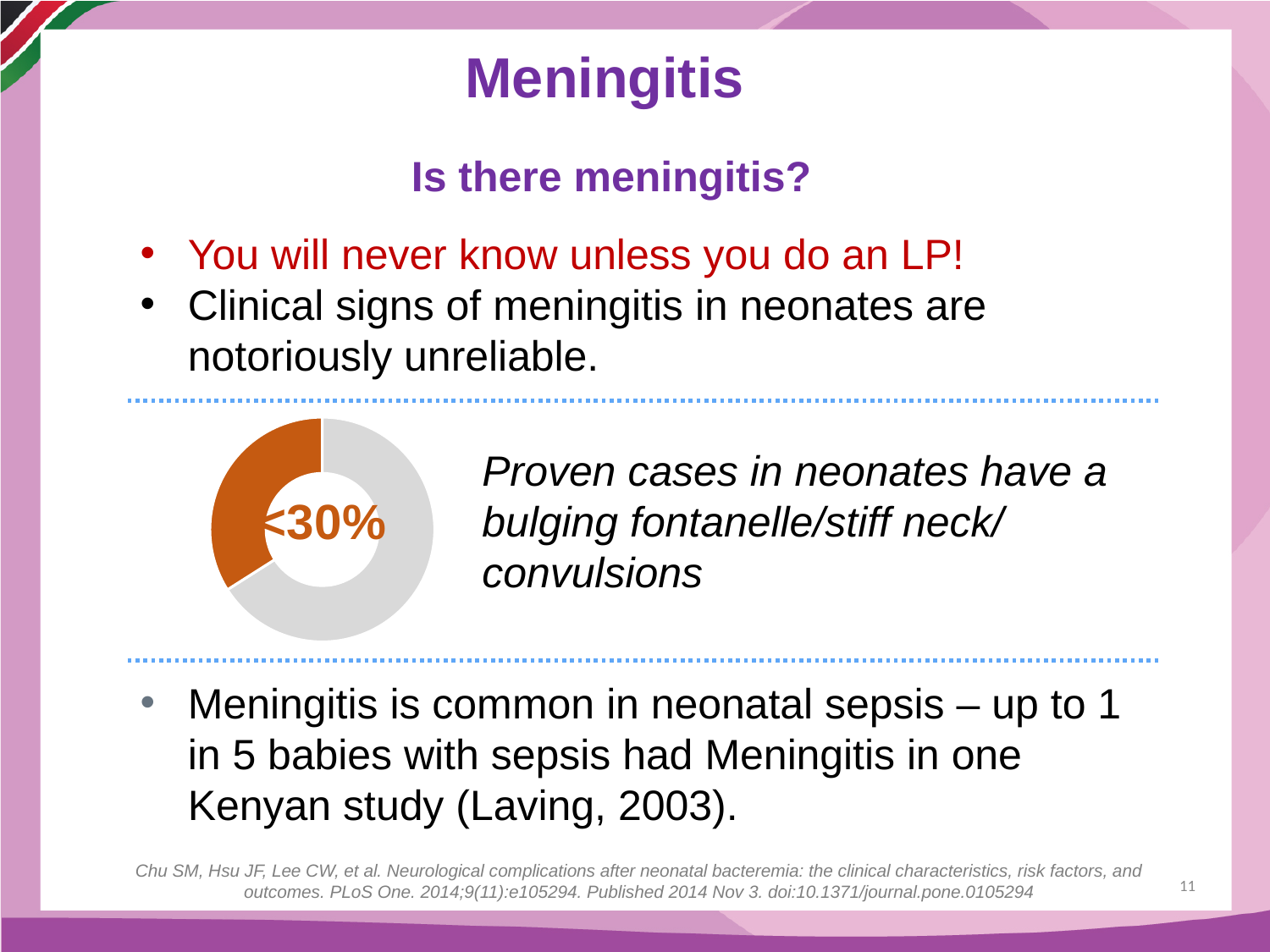
What colour is the smaller segment of the donut chart? Orange What kind of chart is shown on the slide? Donut chart What value is printed in the centre of the donut chart? <30% What share of the donut chart does the orange segment represent, according to the label? <30% What does the text beside the donut chart say the <30% refers to? Proven cases in neonates have a bulging fontanelle/stiff neck/convulsions How many segments does the donut chart have? 2 Is the orange segment of the donut chart greater or less than 50% of the whole? less Which segment of the donut chart is larger, the orange one or the grey one? Grey